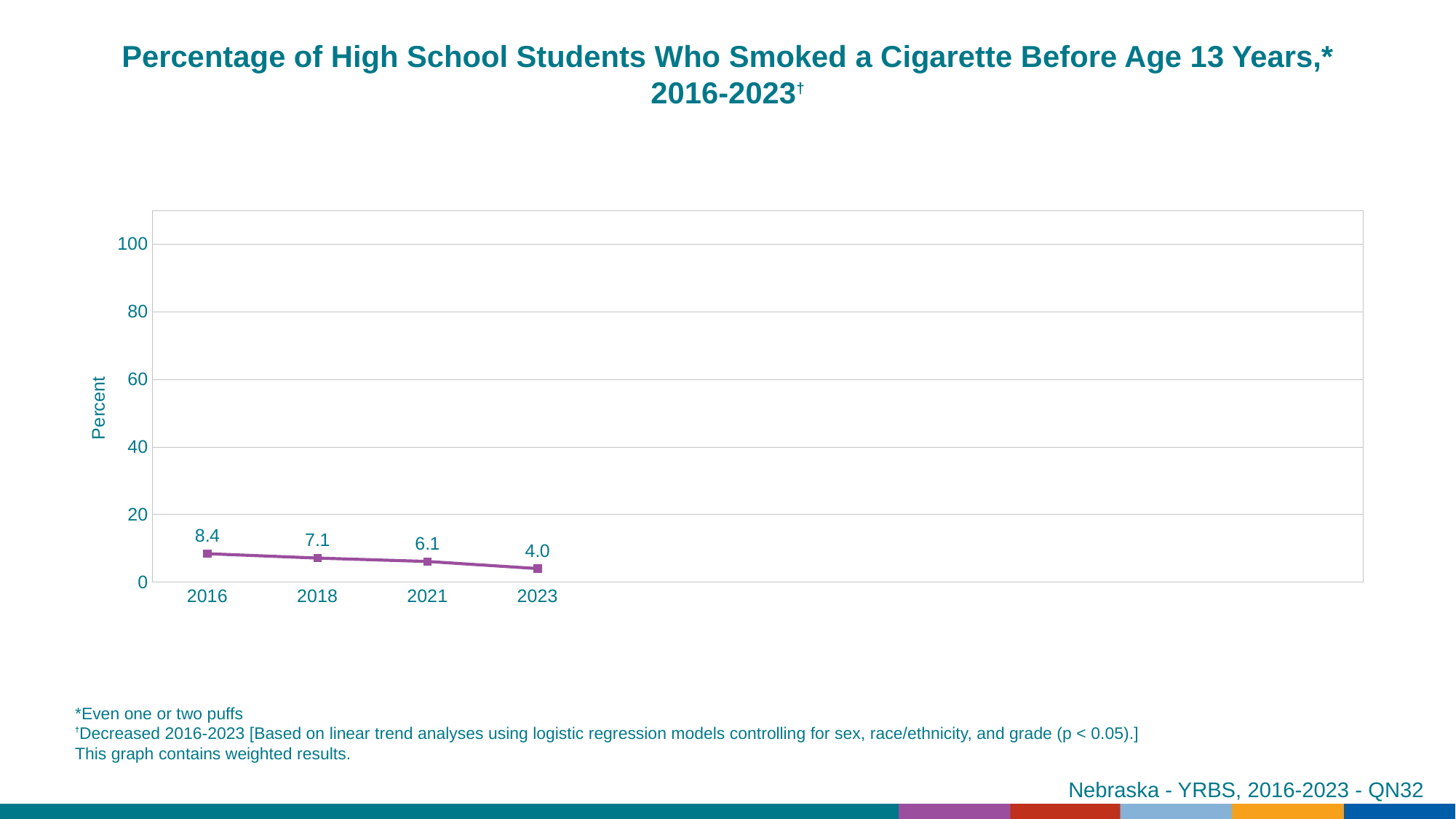
Do the values rise or fall from 2016 to 2023? fall What is the value for 2023? 4.0 Which year has the highest value? 2016 What is the label of the y axis? Percent What is the difference between the values for 2016 and 2023? 4.4 What is the value for 2016? 8.4 How many years are plotted on the chart? 4 Which year has the lowest value? 2023 Which is larger, the value for 2018 or the value for 2021? 2018 What is the value for 2021? 6.1 Is the value for 2016 greater or less than 20? less What kind of chart is shown? line chart